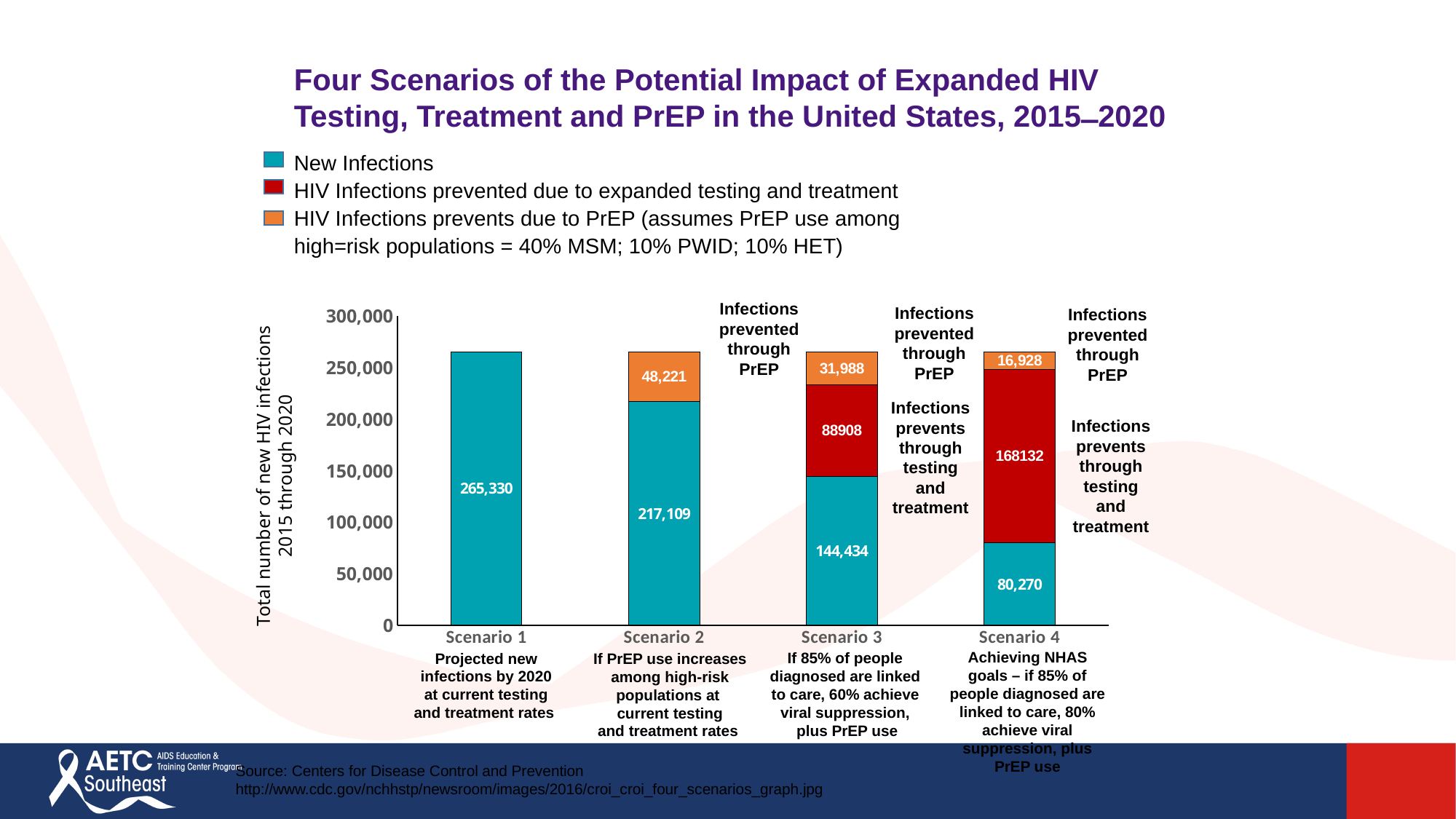
How many series does the legend list? 3 How many HIV infections are prevented due to expanded testing and treatment in Scenario 3? 88908 What is the number of new infections in Scenario 4? 80,270 How many HIV infections are prevented due to PrEP in Scenario 2? 48,221 What is the difference in new infections between Scenario 2 and Scenario 3? 72,675 What is the total height of the stacked bar for Scenario 4? 265,330 What type of chart is shown on the slide? Stacked bar chart Which scenario has the lowest number of new infections? Scenario 4 Which is larger: infections prevented through testing and treatment in Scenario 3 or in Scenario 4? Scenario 4 How many scenarios are shown on the x axis? 4 What is the number of new infections in Scenario 1? 265,330 Which scenario has the highest number of new infections? Scenario 1